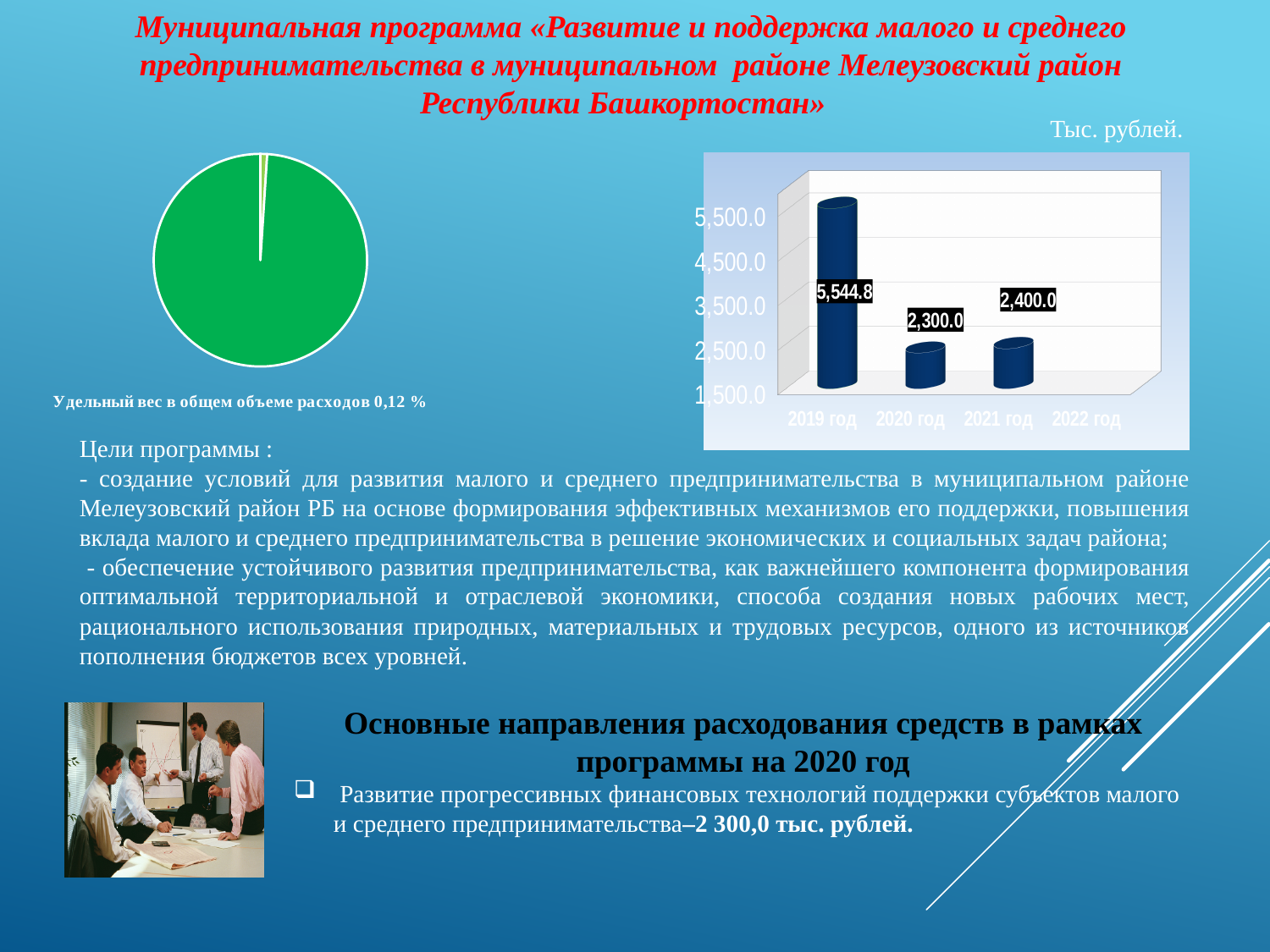
In the bar chart on the right, which is larger, the value for 2020 год or 2021 год? 2021 год What kind of chart is the chart on the left of the slide? pie chart How many year categories are shown on the x axis of the bar chart on the right? 4 In the bar chart on the right, what is the value for 2019 год? 5,544.8 In the bar chart on the right, what is the value for 2021 год? 2,400.0 In the bar chart on the right, what is the difference between the values for 2021 год and 2020 год? 100.0 In the bar chart on the right, which of the years with a labelled bar has the lowest value? 2020 год What kind of chart is the chart on the right of the slide? bar chart In the bar chart on the right, is the value for 2019 год greater or less than 4,500.0? greater In the bar chart on the right, what is the difference between the values for 2019 год and 2020 год? 3,244.8 In the bar chart on the right, what is the value for 2020 год? 2,300.0 In the bar chart on the right, which year has the highest value? 2019 год